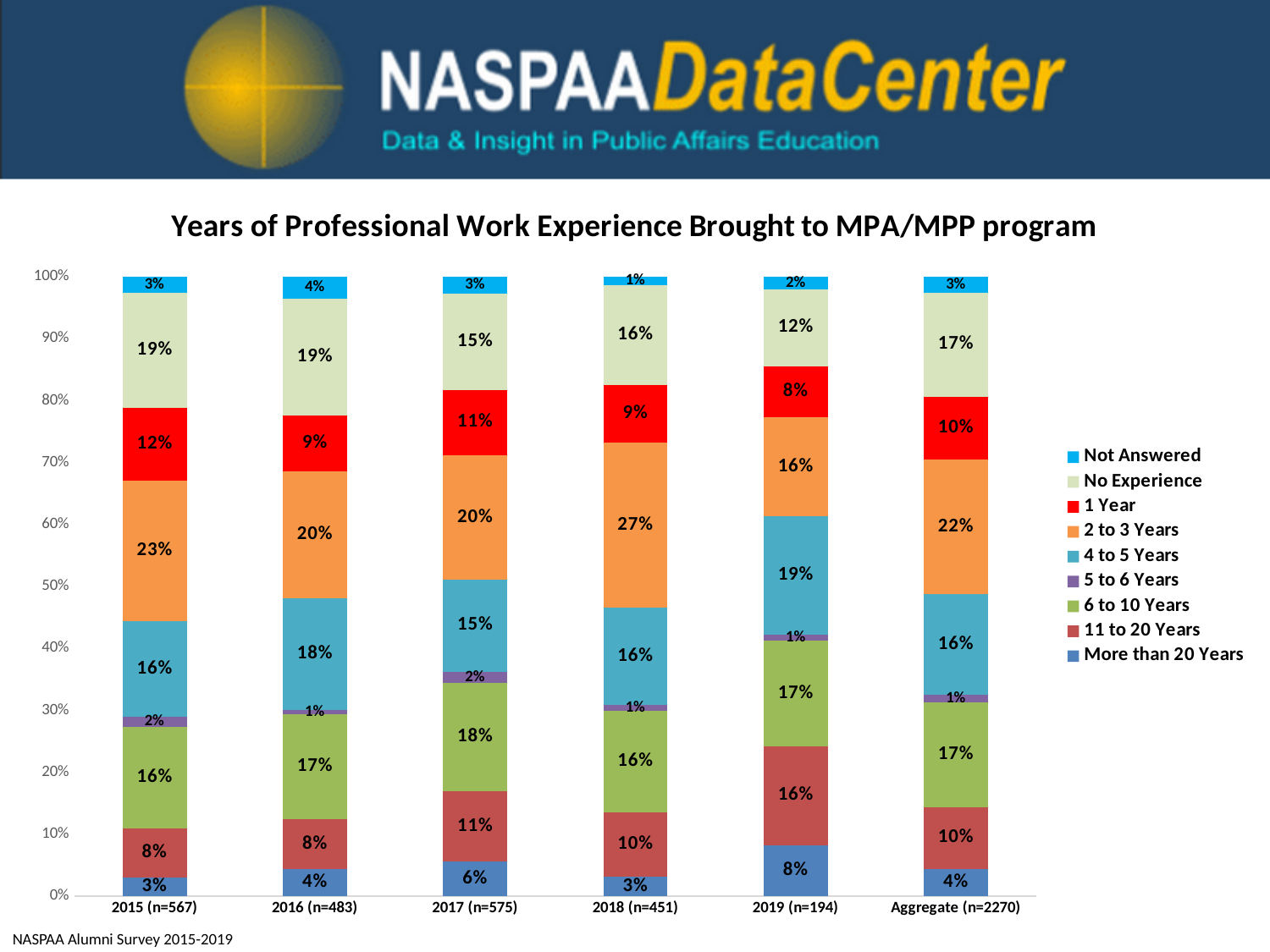
Which category has the lowest Not Answered percentage? 2018 (n=451) How many bars (categories) are shown on the x axis? 6 What is the 4 to 5 Years value for 2019 (n=194)? 19% What percentage of 2018 (n=451) respondents brought 2 to 3 Years of experience? 27% What is the difference between the 1 Year value for 2015 (n=567) and for 2016 (n=483)? 3 percentage points How many series does the legend list? 9 What is the value for More than 20 Years in the 2019 (n=194) bar? 8% Which has a larger 11 to 20 Years value, 2019 (n=194) or 2015 (n=567)? 2019 (n=194) What is the No Experience share in the Aggregate (n=2270) bar? 17% What kind of chart is shown on the slide? Stacked bar chart Which category has the highest 2 to 3 Years percentage? 2018 (n=451) What is the title of the chart? Years of Professional Work Experience Brought to MPA/MPP program